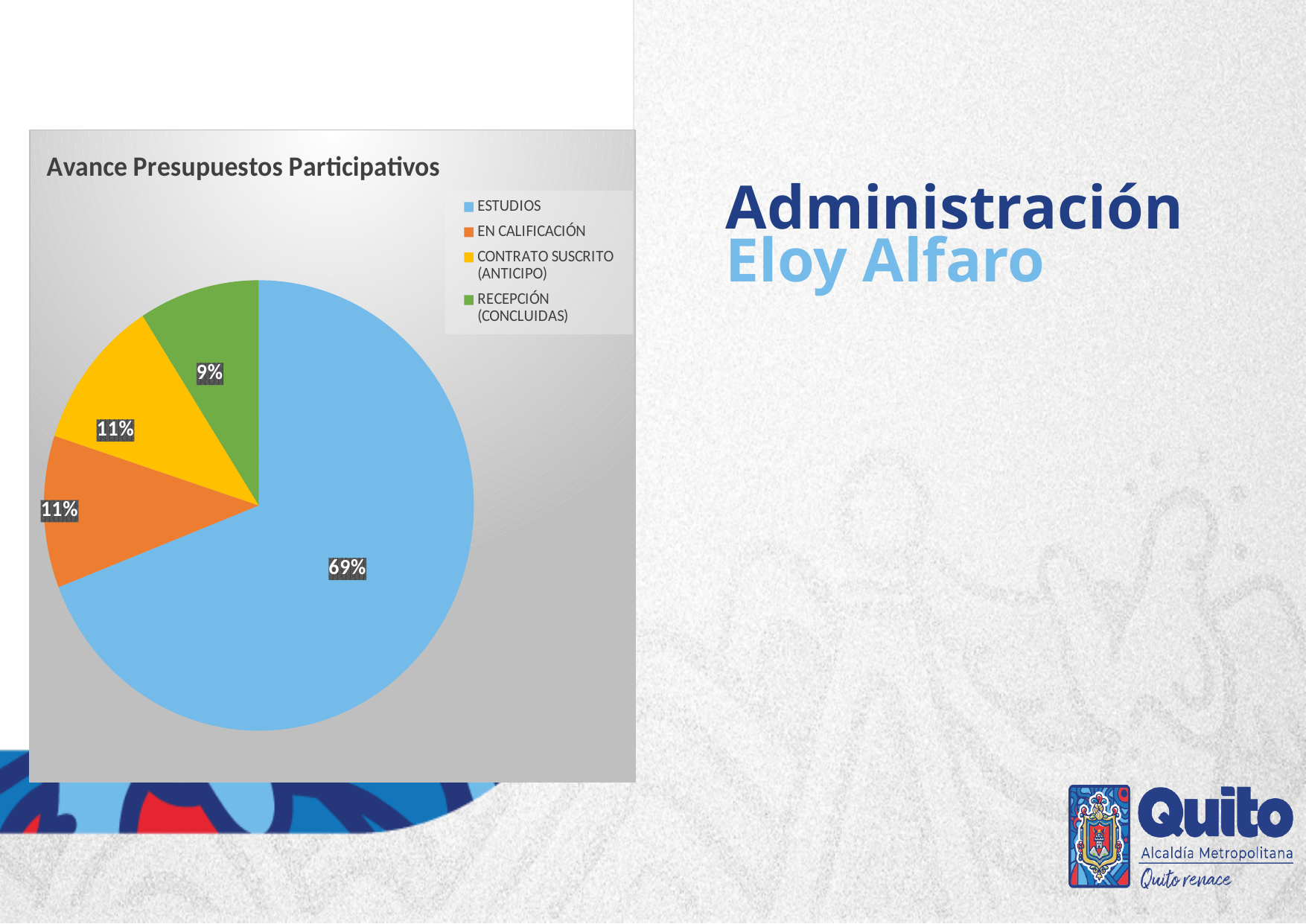
What share of the pie does RECEPCIÓN (CONCLUIDAS) represent? 9% What type of chart is shown on the slide? pie chart Which is larger, the share for ESTUDIOS or the share for EN CALIFICACIÓN? ESTUDIOS What share of the pie does ESTUDIOS represent? 69% What colour is the ESTUDIOS slice in the pie chart? blue What is the difference in percentage points between ESTUDIOS and RECEPCIÓN (CONCLUIDAS)? 60 Which category has the smallest slice of the pie? RECEPCIÓN (CONCLUIDAS) What share of the pie does EN CALIFICACIÓN represent? 11% How many categories does the pie chart show? 4 What is the title of the chart? Avance Presupuestos Participativos Which category has the largest slice of the pie? ESTUDIOS